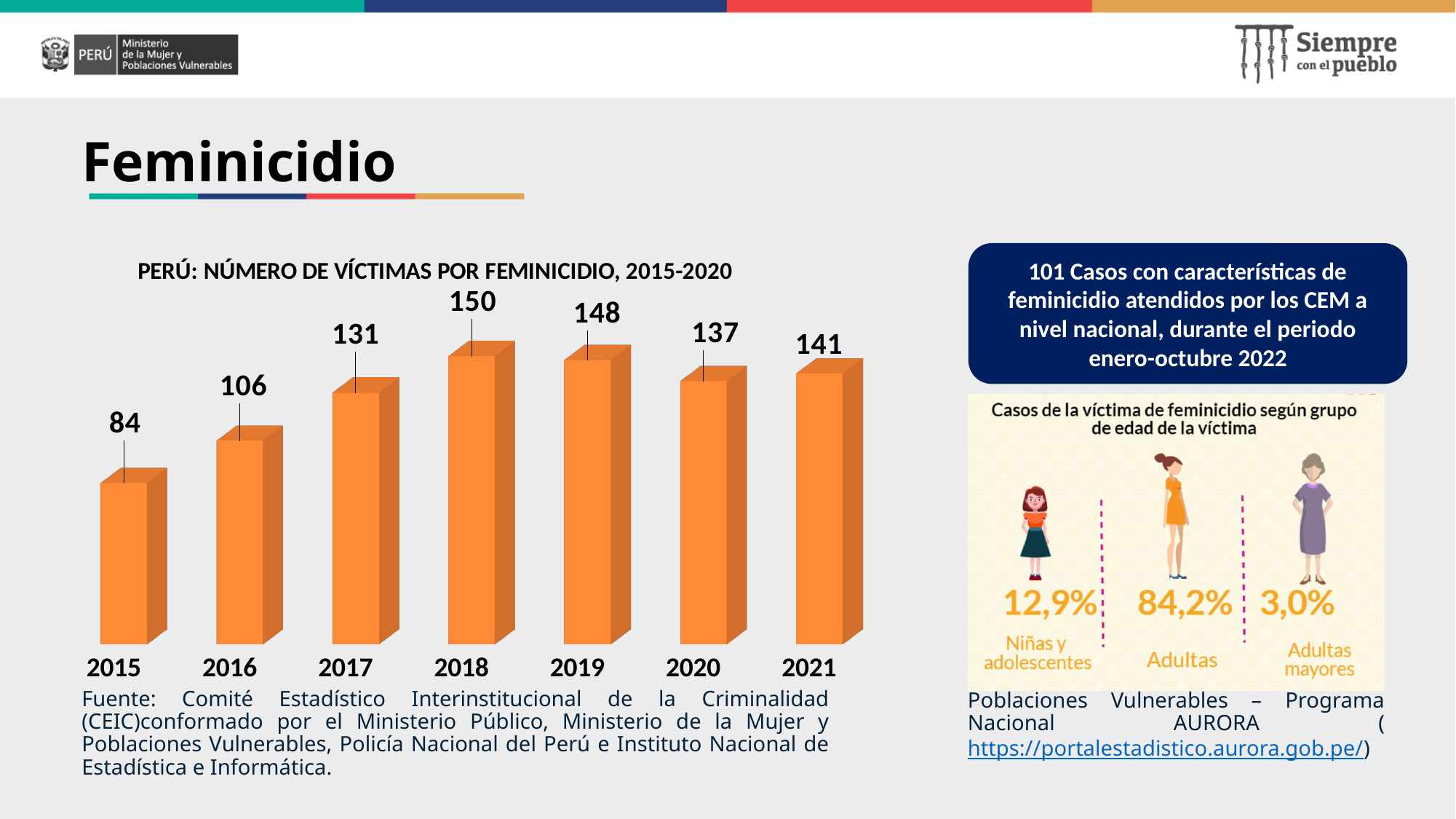
What kind of chart is 'PERÚ: NÚMERO DE VÍCTIMAS POR FEMINICIDIO, 2015-2020'? Bar chart In the bar chart 'PERÚ: NÚMERO DE VÍCTIMAS POR FEMINICIDIO, 2015-2020', which is larger, the value for 2020 or the value for 2021? 2021 What colour are the bars in the bar chart 'PERÚ: NÚMERO DE VÍCTIMAS POR FEMINICIDIO, 2015-2020'? Orange In the bar chart 'PERÚ: NÚMERO DE VÍCTIMAS POR FEMINICIDIO, 2015-2020', what is the value for 2019? 148 In the bar chart 'PERÚ: NÚMERO DE VÍCTIMAS POR FEMINICIDIO, 2015-2020', what is the difference between the values for 2017 and 2016? 25 In the bar chart 'PERÚ: NÚMERO DE VÍCTIMAS POR FEMINICIDIO, 2015-2020', which year has the highest value? 2018 In the bar chart 'PERÚ: NÚMERO DE VÍCTIMAS POR FEMINICIDIO, 2015-2020', what is the value for 2015? 84 In the bar chart 'PERÚ: NÚMERO DE VÍCTIMAS POR FEMINICIDIO, 2015-2020', which year has the lowest value? 2015 In the bar chart 'PERÚ: NÚMERO DE VÍCTIMAS POR FEMINICIDIO, 2015-2020', what is the difference between the values for 2018 and 2015? 66 In the bar chart 'PERÚ: NÚMERO DE VÍCTIMAS POR FEMINICIDIO, 2015-2020', do the values rise or fall from 2015 to 2018? Rise In the bar chart 'PERÚ: NÚMERO DE VÍCTIMAS POR FEMINICIDIO, 2015-2020', what is the value for 2021? 141 How many years (bars) are shown in the bar chart 'PERÚ: NÚMERO DE VÍCTIMAS POR FEMINICIDIO, 2015-2020'? 7